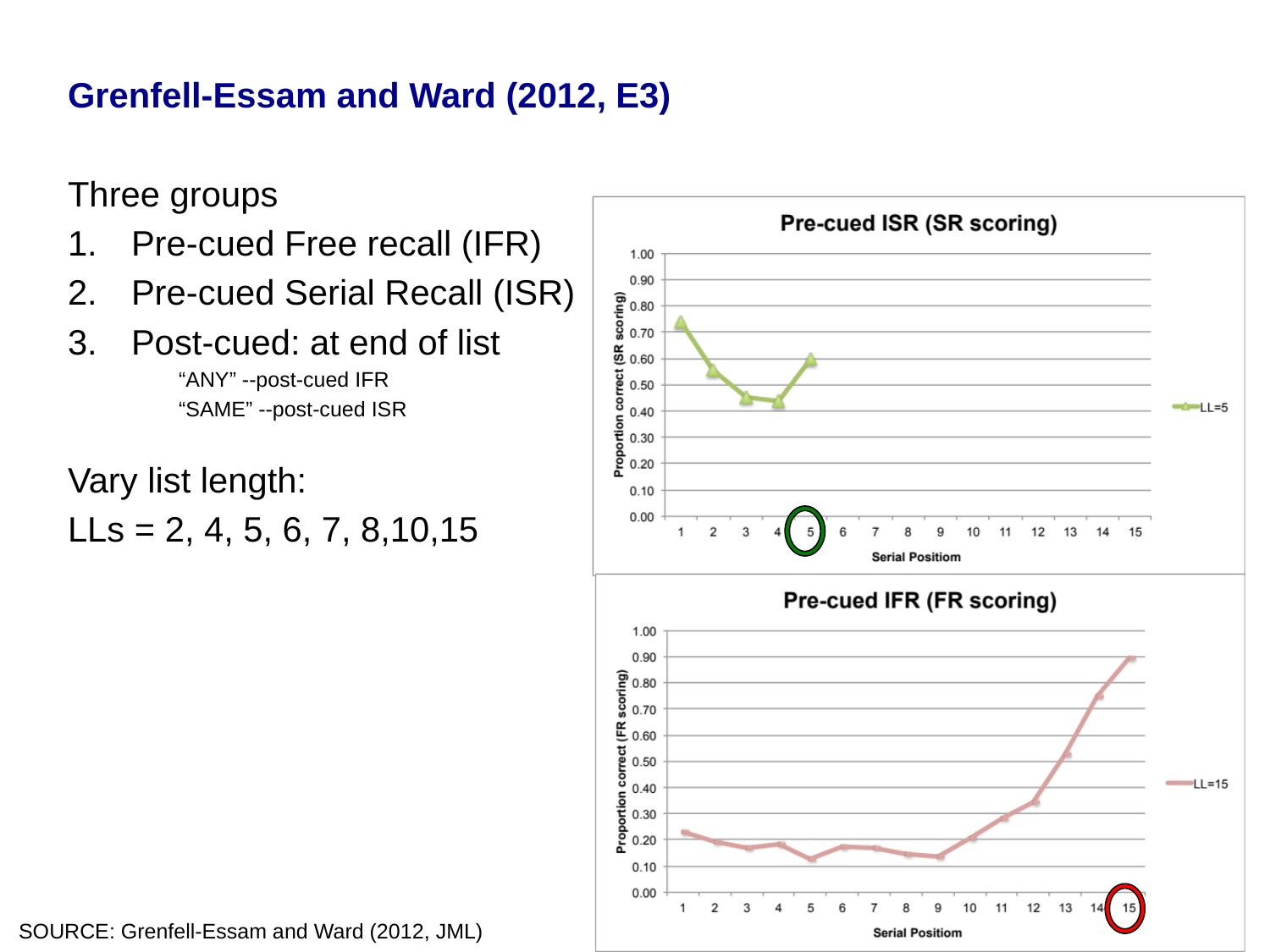
In the 'Pre-cued IFR (FR scoring)' chart, is the value at serial position 9 greater or less than 0.20? less In the 'Pre-cued ISR (SR scoring)' chart, how many serial positions have plotted points? 5 In the 'Pre-cued IFR (FR scoring)' chart, how many serial positions have plotted points? 15 In the 'Pre-cued ISR (SR scoring)' chart, is the value at serial position 4 greater or less than 0.50? less In the 'Pre-cued IFR (FR scoring)' chart, is the value at serial position 15 greater or less than 0.80? greater In the 'Pre-cued IFR (FR scoring)' chart, which serial position has the highest proportion correct? 15 In the 'Pre-cued ISR (SR scoring)' chart, which serial position has the highest proportion correct? 1 What kind of chart is the 'Pre-cued ISR (SR scoring)' chart? line chart In the 'Pre-cued IFR (FR scoring)' chart, do the values rise or fall from serial position 9 to serial position 15? rise How many series does the legend of the 'Pre-cued IFR (FR scoring)' chart list? 1 In the 'Pre-cued ISR (SR scoring)' chart, which is larger: the value at serial position 1 or at serial position 5? serial position 1 What is the legend entry in the 'Pre-cued ISR (SR scoring)' chart? LL=5